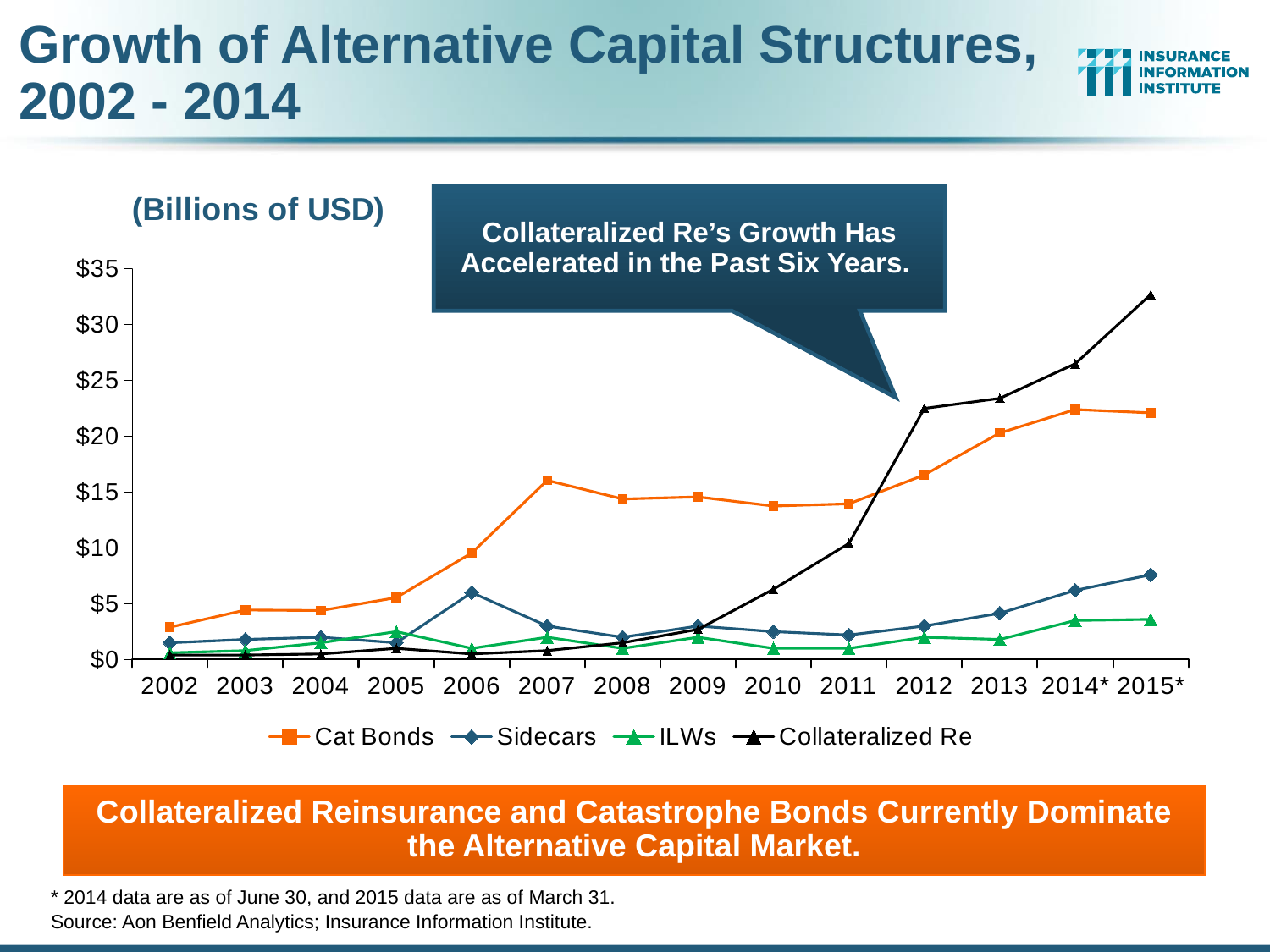
In 2012, which is larger: Cat Bonds or Collateralized Re? Collateralized Re Which series has the lowest value in 2015*? ILWs Is the value for Cat Bonds in 2014* greater or less than $20? greater Is the value for Sidecars in 2015* greater or less than $5? greater What kind of chart is shown on the slide? Line chart Which series has the highest value in 2015*? Collateralized Re How many series does the legend list? 4 In 2007, which is larger: Cat Bonds or Sidecars? Cat Bonds Is the value for ILWs in 2015* greater or less than $5? less How many years are shown along the x axis? 14 Does the Collateralized Re line rise or fall from 2009 to 2015*? Rise